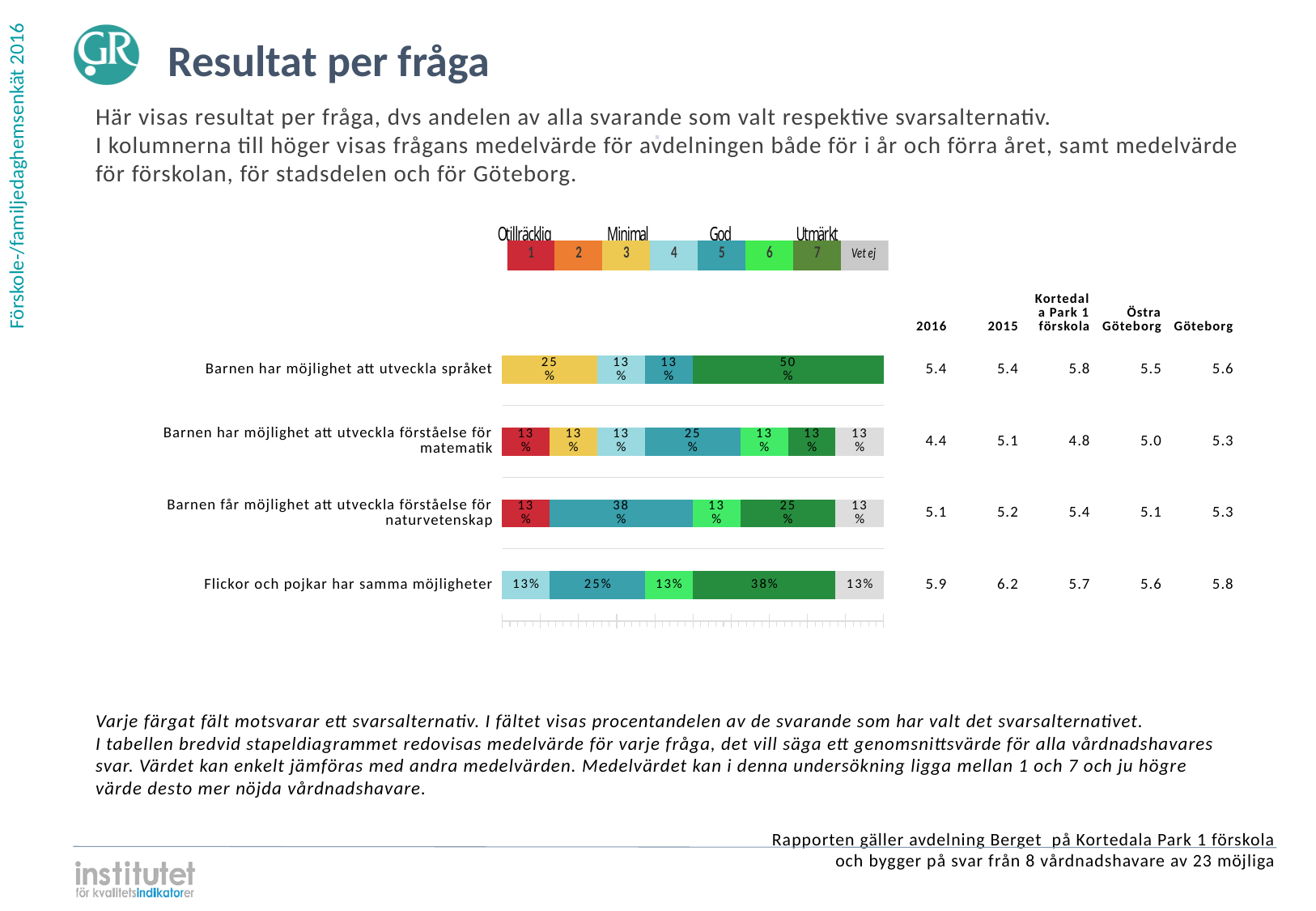
What percentage of respondents chose option 5 (teal) for 'Barnen får möjlighet att utveckla förståelse för naturvetenskap'? 38% Which question has the largest single segment in the chart? Barnen har möjlighet att utveckla språket What percentage of respondents chose option 5 (teal) for 'Barnen har möjlighet att utveckla förståelse för matematik'? 25% How many questions (categories) are plotted in the bar chart? 4 What kind of chart is used to show the results per question? Stacked bar chart What label does the legend give to the grey segment at the right end of the bars? Vet ej What percentage of respondents chose option 3 (yellow) for 'Barnen har möjlighet att utveckla språket'? 25% What percentage of respondents chose option 7 (dark green) for 'Barnen har möjlighet att utveckla språket'? 50% What is the difference between the option 7 share for 'Barnen har möjlighet att utveckla språket' (50%) and the option 7 share for 'Flickor och pojkar har samma möjligheter' (38%)? 12 percentage points Which is larger: the option 5 share for 'Barnen får möjlighet att utveckla förståelse för naturvetenskap' or the option 5 share for 'Flickor och pojkar har samma möjligheter'? Barnen får möjlighet att utveckla förståelse för naturvetenskap What percentage of respondents answered 'Vet ej' for 'Flickor och pojkar har samma möjligheter'? 13% How many response options does the legend above the chart list, including 'Vet ej'? 8